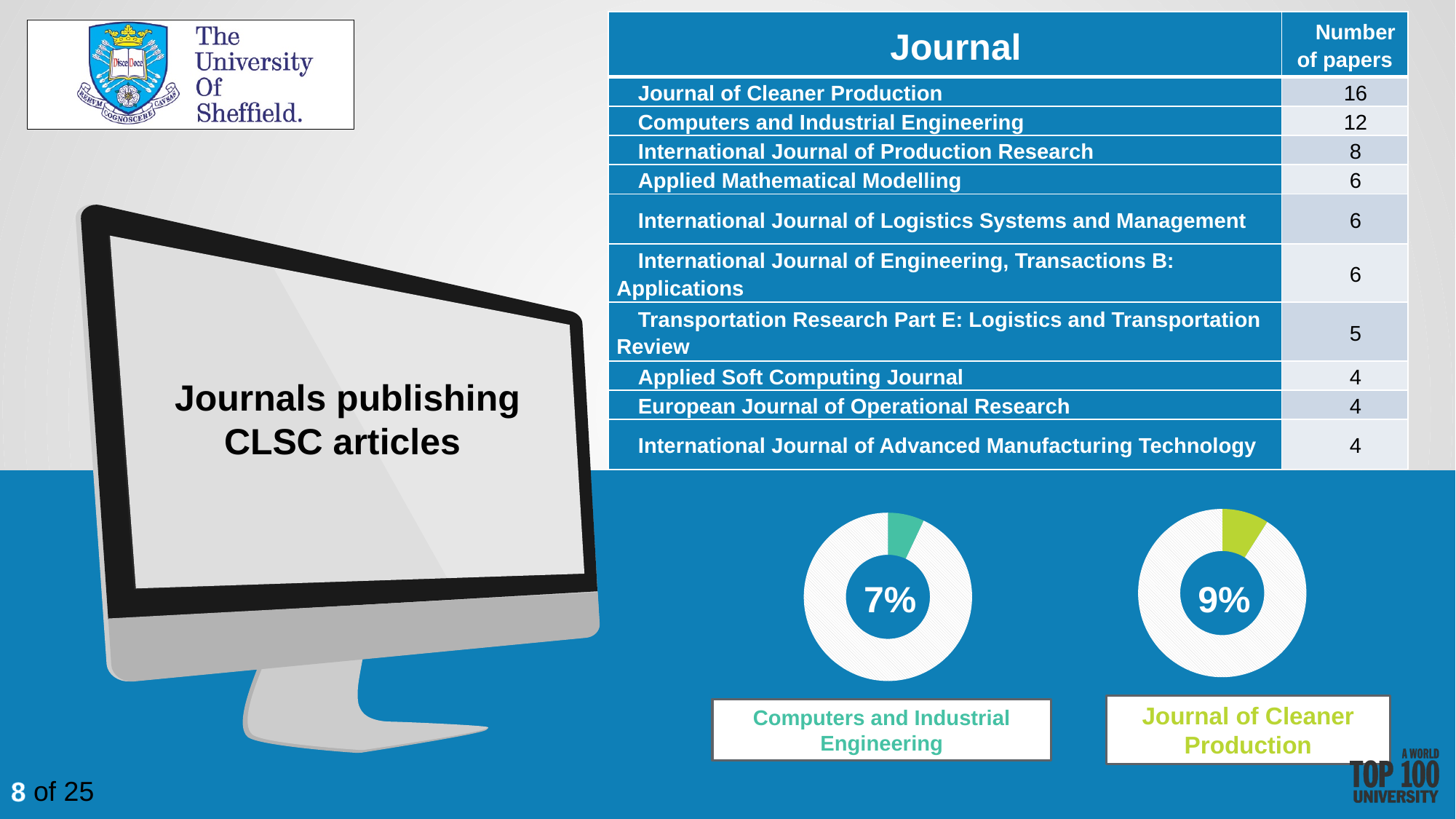
Which journal is the donut chart on the left of the slide labelled with? Computers and Industrial Engineering In the donut chart labelled Computers and Industrial Engineering, what percentage is shown in the centre? 7% What colour is the highlighted slice in the Journal of Cleaner Production donut chart? Yellow-green What colour is the highlighted slice in the Computers and Industrial Engineering donut chart? Teal green Which of the two donut charts shows the larger percentage, Computers and Industrial Engineering or Journal of Cleaner Production? Journal of Cleaner Production In the Computers and Industrial Engineering donut chart, is the highlighted share greater or less than 50%? less How many donut charts are shown on the slide? 2 What is the difference between the percentage shown in the Journal of Cleaner Production donut chart and the percentage shown in the Computers and Industrial Engineering donut chart? 2% In the donut chart labelled Journal of Cleaner Production, what percentage is shown in the centre? 9% Which journal is the donut chart on the right of the slide labelled with? Journal of Cleaner Production In the Journal of Cleaner Production donut chart, is the highlighted share greater or less than 25%? less What kind of chart is used to show the 7% and 9% values on the slide? Donut chart